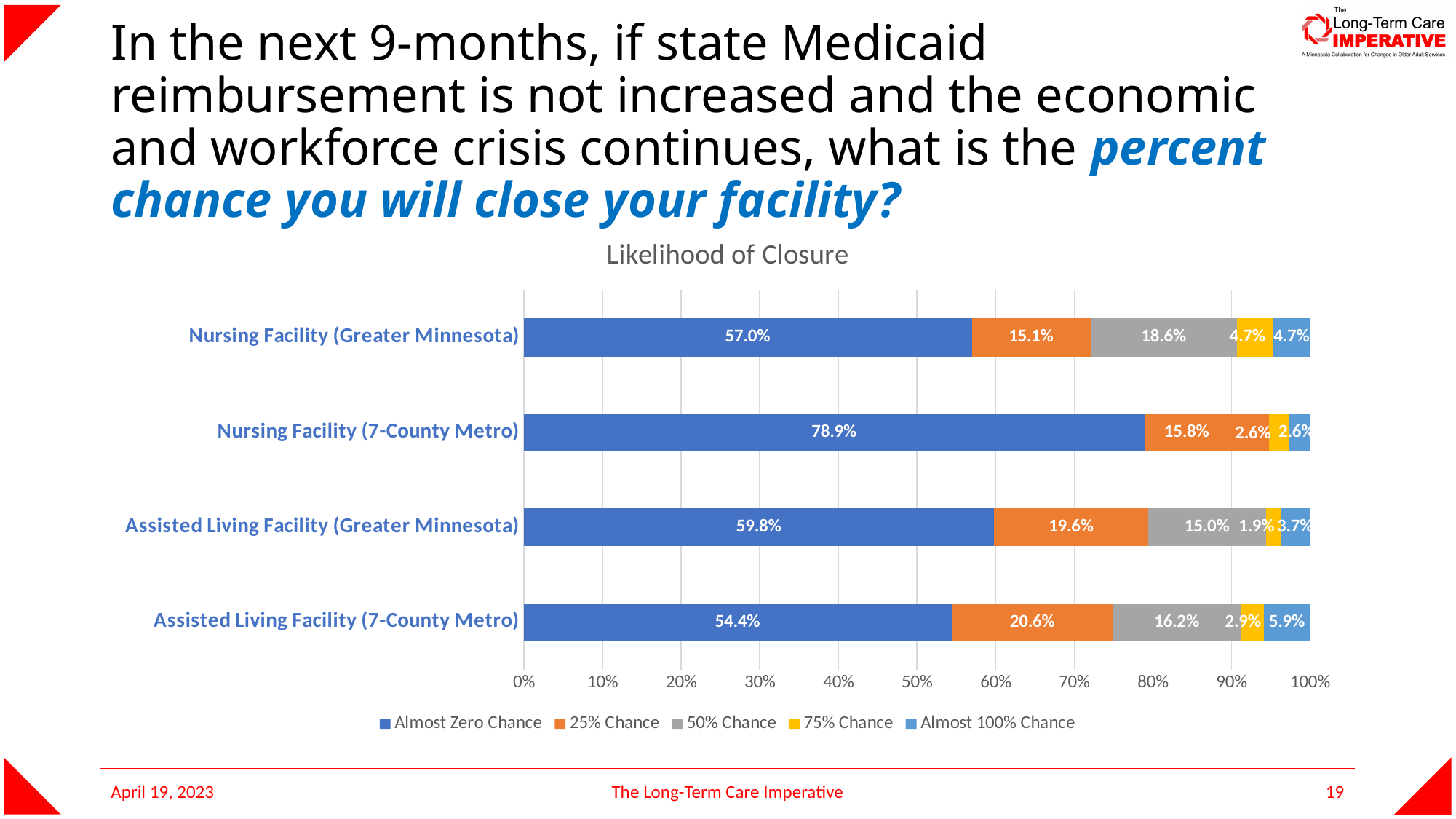
What is the Almost Zero Chance value for Nursing Facility (7-County Metro)? 78.9% Which category has the lowest Almost Zero Chance value? Assisted Living Facility (7-County Metro) Which category has the highest Almost 100% Chance value? Assisted Living Facility (7-County Metro) What type of chart is shown on the slide? Stacked bar chart What is the 25% Chance value for Assisted Living Facility (7-County Metro)? 20.6% What is the 50% Chance value for Nursing Facility (Greater Minnesota)? 18.6% What is the difference between the Almost Zero Chance values for Nursing Facility (Greater Minnesota) and Assisted Living Facility (7-County Metro)? 2.6 percentage points What is the Almost 100% Chance value for Assisted Living Facility (7-County Metro)? 5.9% How many facility categories are shown in the chart? 4 How many series does the legend list? 5 Which category has the highest Almost Zero Chance value? Nursing Facility (7-County Metro) Which has a larger 25% Chance value: Assisted Living Facility (Greater Minnesota) or Nursing Facility (Greater Minnesota)? Assisted Living Facility (Greater Minnesota)